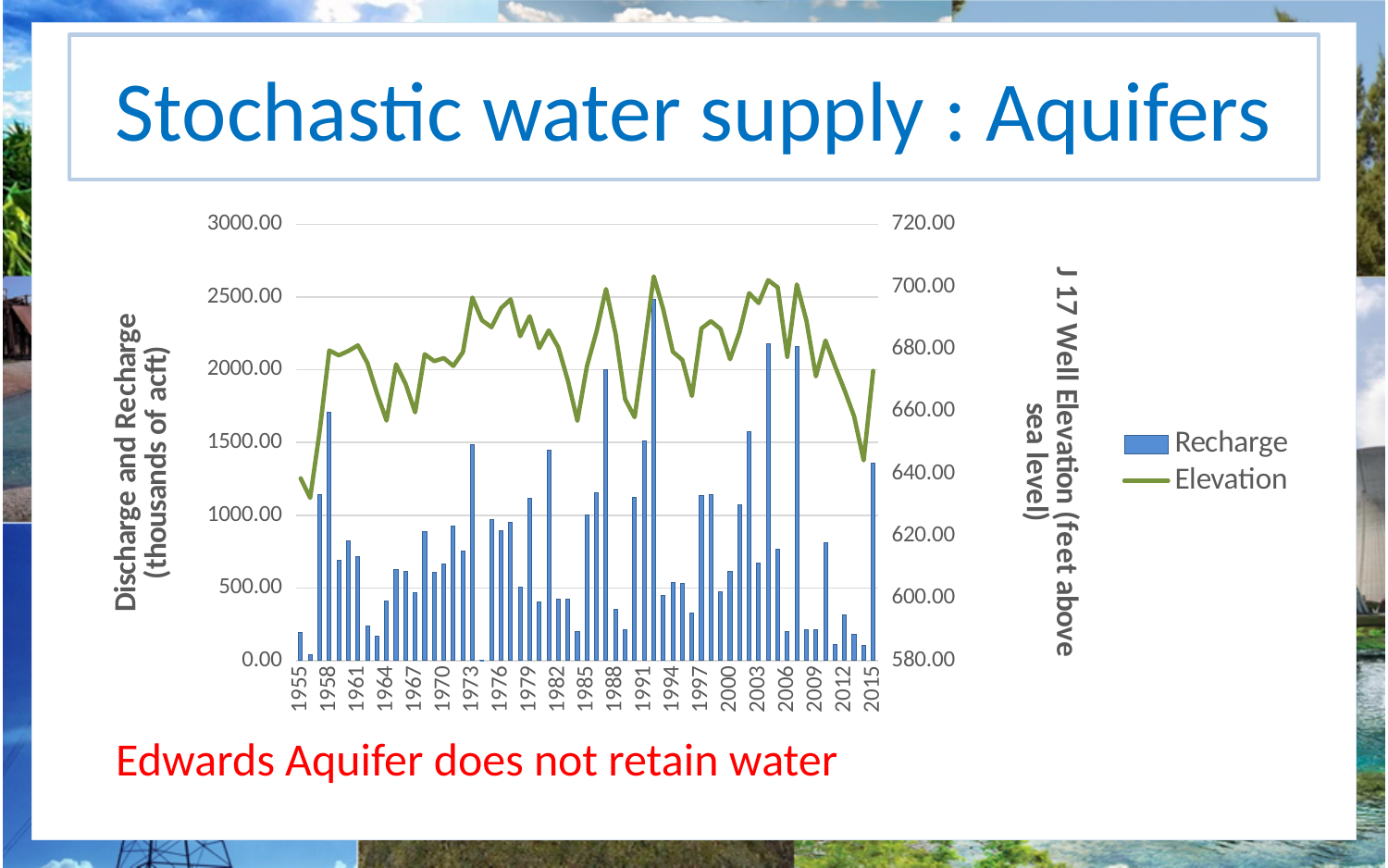
Is the Recharge value for 1958 greater or less than 1500.00? greater Is the Recharge value for 1955 greater or less than 500.00? less What are the two series named in the chart legend? Recharge and Elevation Is the Elevation value for 2015 greater or less than 660.00? greater What is the highest value shown on the left vertical axis? 3000.00 How many series does the chart legend list? 2 Which series is drawn as bars, Recharge or Elevation? Recharge Does the Elevation line rise or fall between 1955 and 1958? rise What kind of chart is shown on the slide? A combined bar and line chart